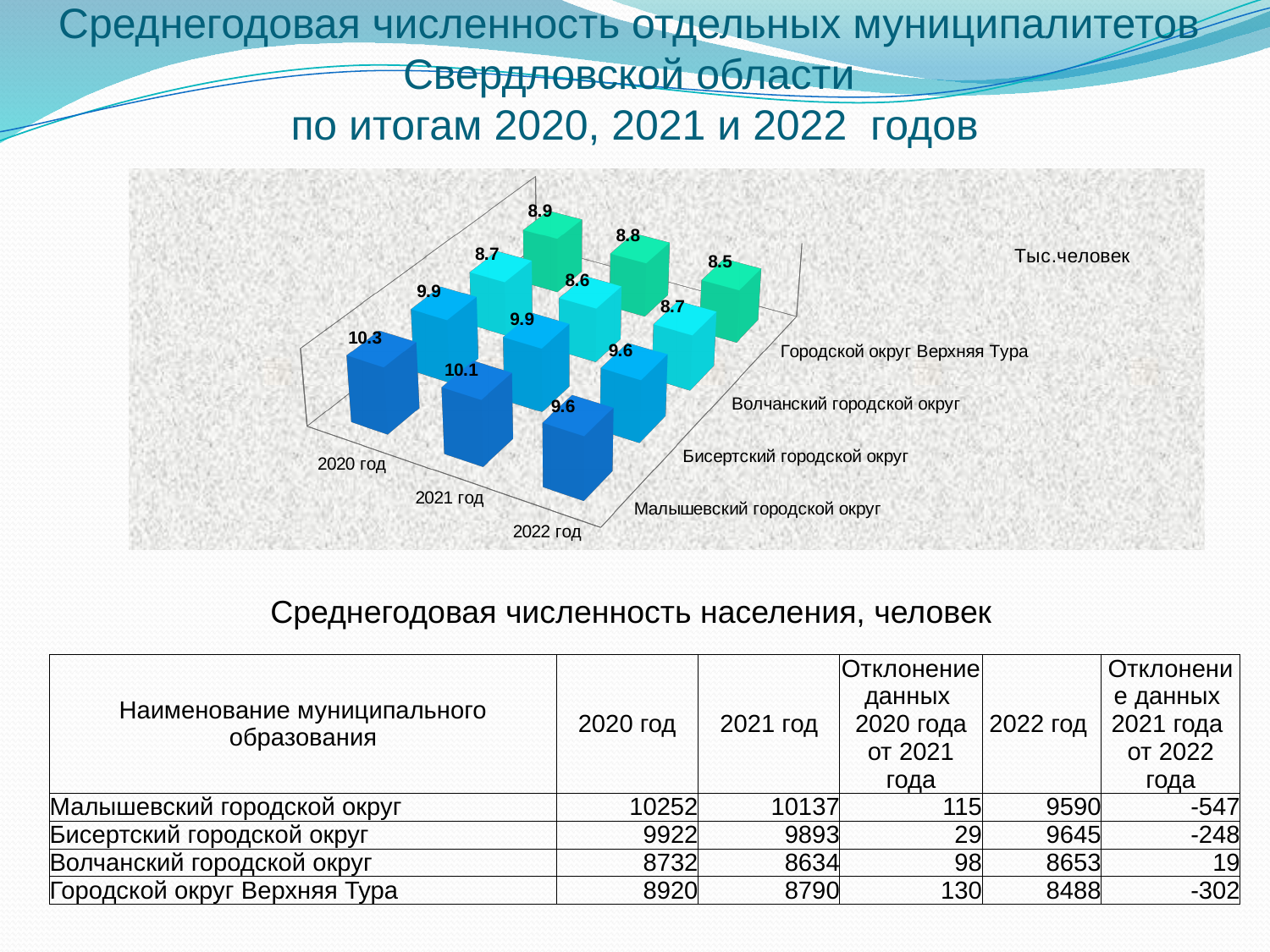
Which municipality has the lowest value in 2022 год on the chart? Городской округ Верхняя Тура What is the difference between the 2020 год and 2022 год values for Малышевский городской округ on the chart? 0.7 Which municipality has the highest value in 2020 год on the chart? Малышевский городской округ What is the value for Городской округ Верхняя Тура in 2022 год on the chart? 8.5 How many years are plotted on the chart? 3 What kind of chart is shown on the slide? 3D bar chart What unit of measurement is indicated on the chart? Тыс.человек How many municipalities are shown on the chart? 4 What is the value for Малышевский городской округ in 2020 год on the chart? 10.3 What is the value for Бисертский городской округ in 2022 год on the chart? 9.6 What is the value for Волчанский городской округ in 2021 год on the chart? 8.6 Which is larger on the chart: the 2021 год value for Бисертский городской округ or the 2021 год value for Городской округ Верхняя Тура? Бисертский городской округ